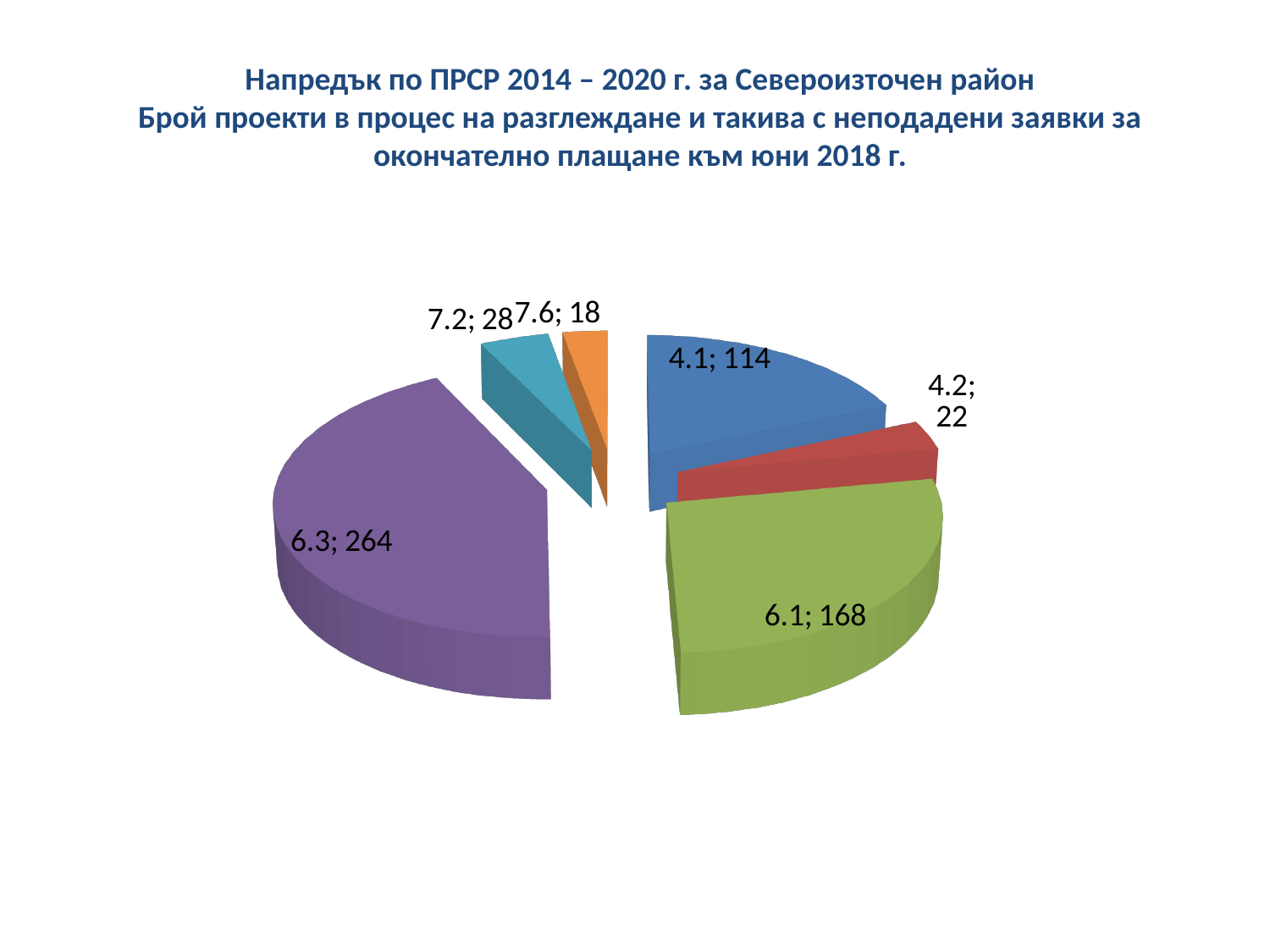
What is the value for category 4.2? 22 What type of chart is shown on the slide? pie chart What is the total of all slice values in the pie chart? 614 Which category has the smallest slice? 7.6 What is the difference between the values for 6.3 and 6.1? 96 How many slices does the pie chart have? 6 What is the value for category 4.1? 114 What colour is the slice for category 6.1? green What is the value for category 7.6? 18 Which category has the largest slice? 6.3 What is the value for category 6.3? 264 Which is larger, the value for 7.2 or the value for 4.2? 7.2